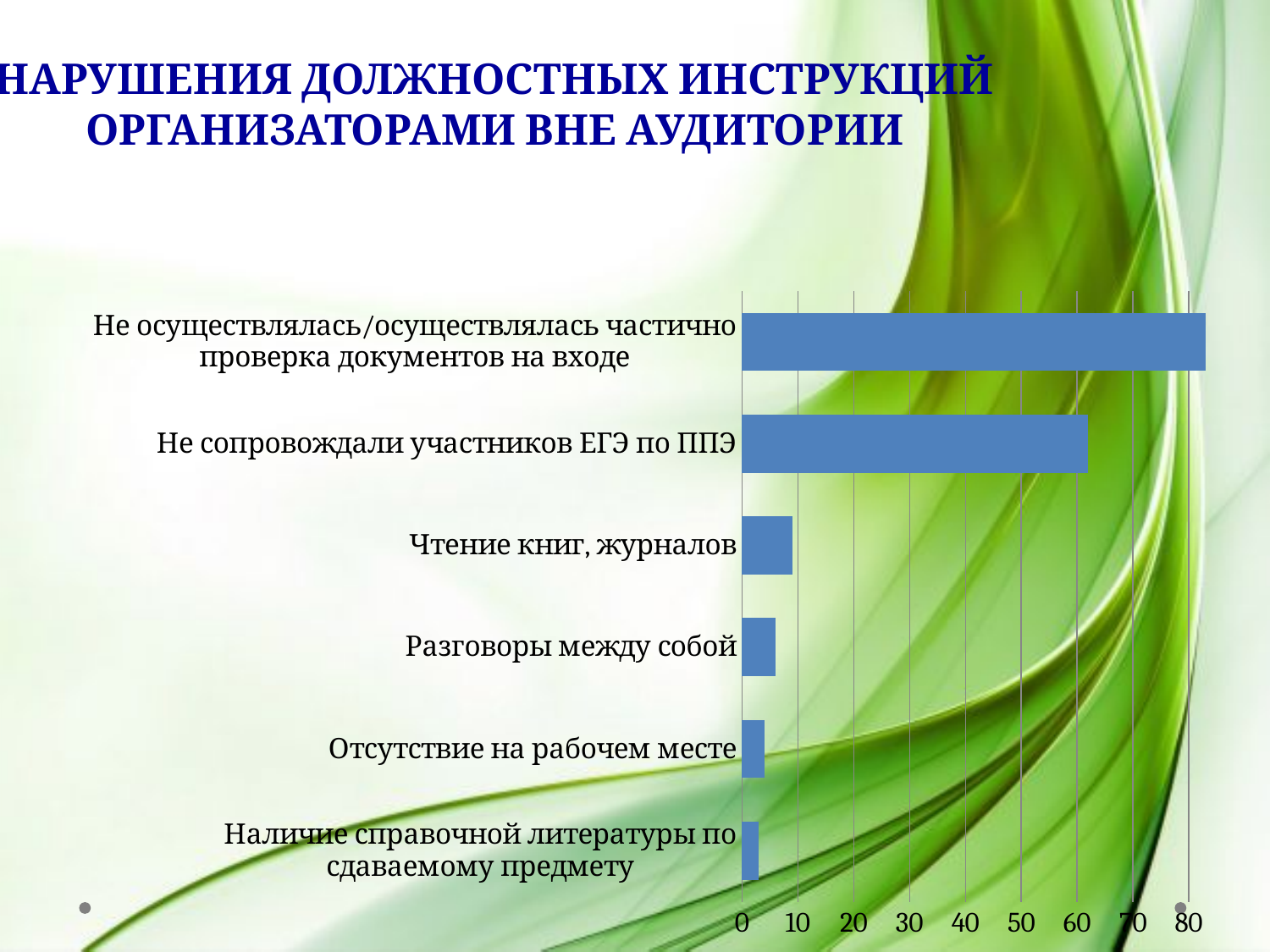
How many categories does the chart show? 6 Which category has the lowest value? Наличие справочной литературы по сдаваемому предмету Is the value for "Отсутствие на рабочем месте" greater or less than 10? less Is the value for "Не сопровождали участников ЕГЭ по ППЭ" greater or less than 60? greater Is the value for "Не сопровождали участников ЕГЭ по ППЭ" greater or less than 70? less What kind of chart is shown on the slide? bar chart Which category has the highest value? Не осуществлялась/осуществлялась частично проверка документов на входе What is the title of the slide containing the chart? НАРУШЕНИЯ ДОЛЖНОСТНЫХ ИНСТРУКЦИЙ ОРГАНИЗАТОРАМИ ВНЕ АУДИТОРИИ Which is larger: the value for "Чтение книг, журналов" or the value for "Разговоры между собой"? Чтение книг, журналов Which is larger: the value for "Не сопровождали участников ЕГЭ по ППЭ" or the value for "Не осуществлялась/осуществлялась частично проверка документов на входе"? Не осуществлялась/осуществлялась частично проверка документов на входе